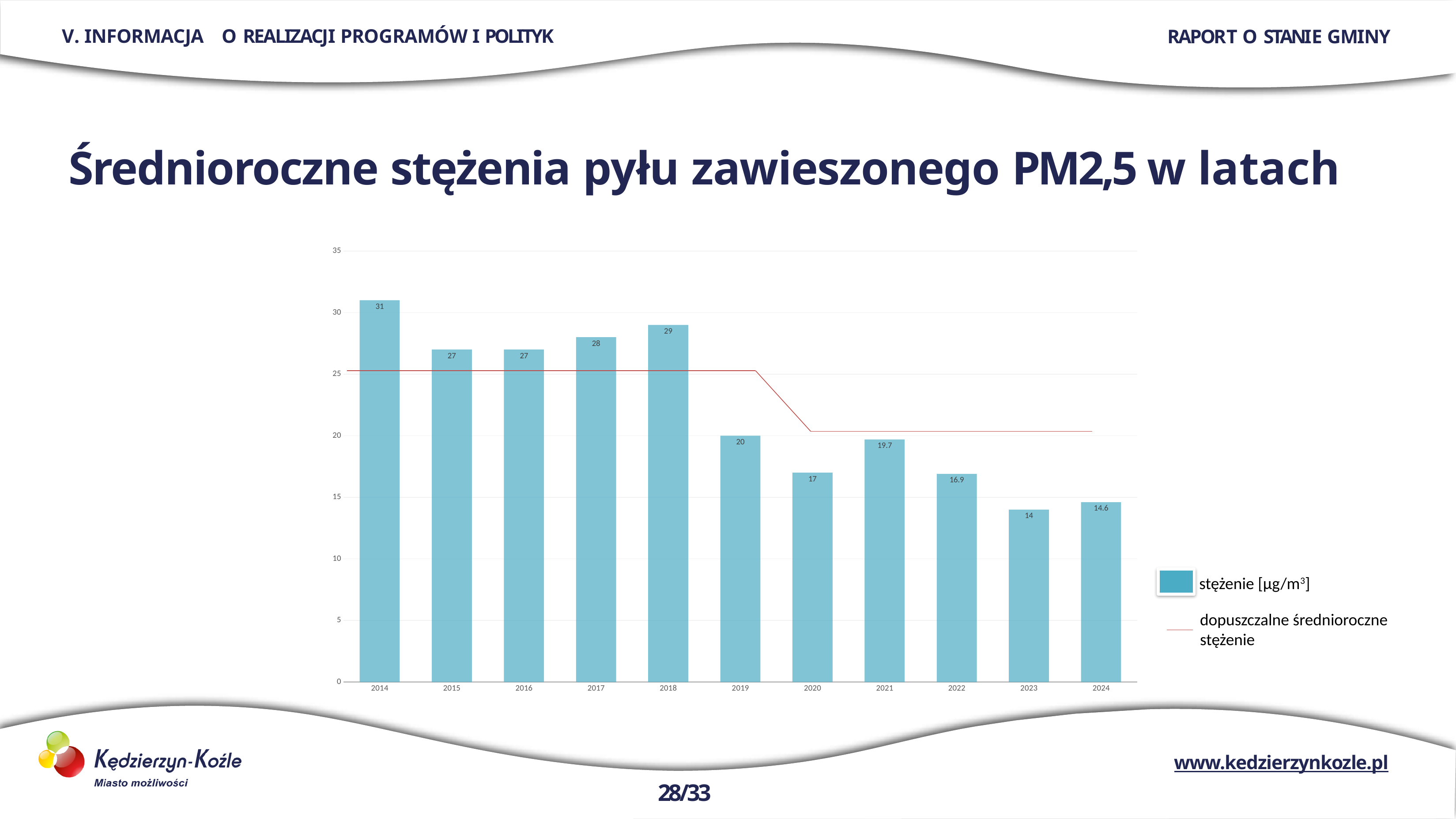
Which year has a higher PM2.5 concentration, 2018 or 2019? 2018 Is the value for 2020 greater or less than 20? less What is the PM2.5 concentration value shown for 2021? 19.7 What kind of chart is used to show the PM2.5 concentrations? bar chart Which year has the highest PM2.5 concentration? 2014 What is the PM2.5 concentration value shown for 2014? 31 Do the PM2.5 concentration values generally rise or fall from 2014 to 2024? fall How many years are shown on the x axis of the chart? 11 What is the PM2.5 concentration value shown for 2024? 14.6 Which year has the lowest PM2.5 concentration? 2023 How many series does the legend list? 2 What is the difference between the PM2.5 concentration in 2014 and in 2024? 16.4